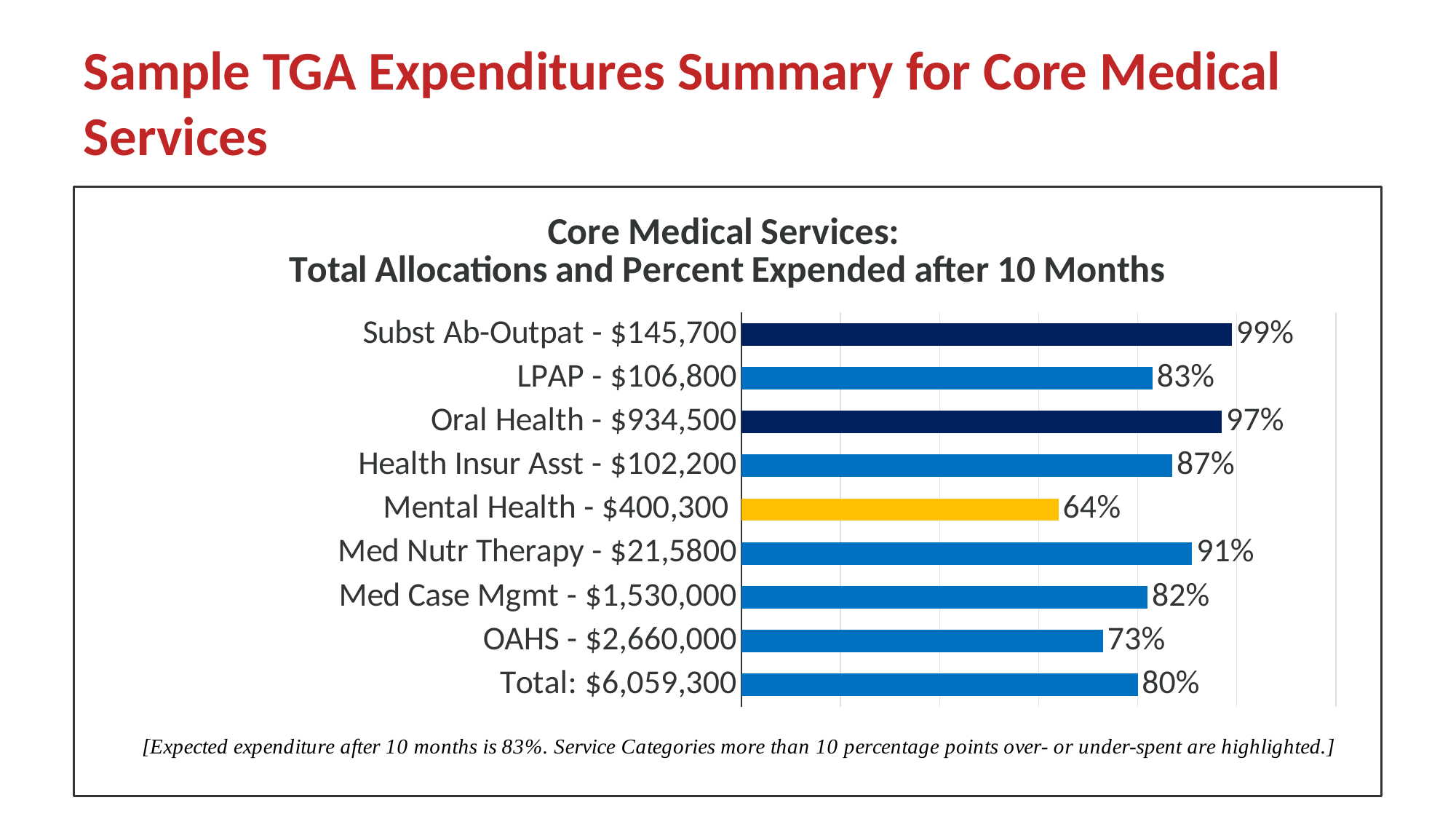
What percent expended is shown for Oral Health? 97% What kind of chart is shown on the slide? Bar chart What percent expended is shown for Mental Health? 64% How many bars are plotted in the chart? 9 Which category has the lowest percent expended? Mental Health Which has a higher percent expended, Med Case Mgmt or OAHS? Med Case Mgmt What is the percent expended for the Total bar? 80% What is the difference in percent expended between Subst Ab-Outpat and Mental Health? 35 percentage points What percent expended is shown for OAHS? 73% Which category has the highest percent expended? Subst Ab-Outpat Which has a higher percent expended, LPAP or Health Insur Asst? Health Insur Asst Which bar is coloured yellow in the chart? Mental Health